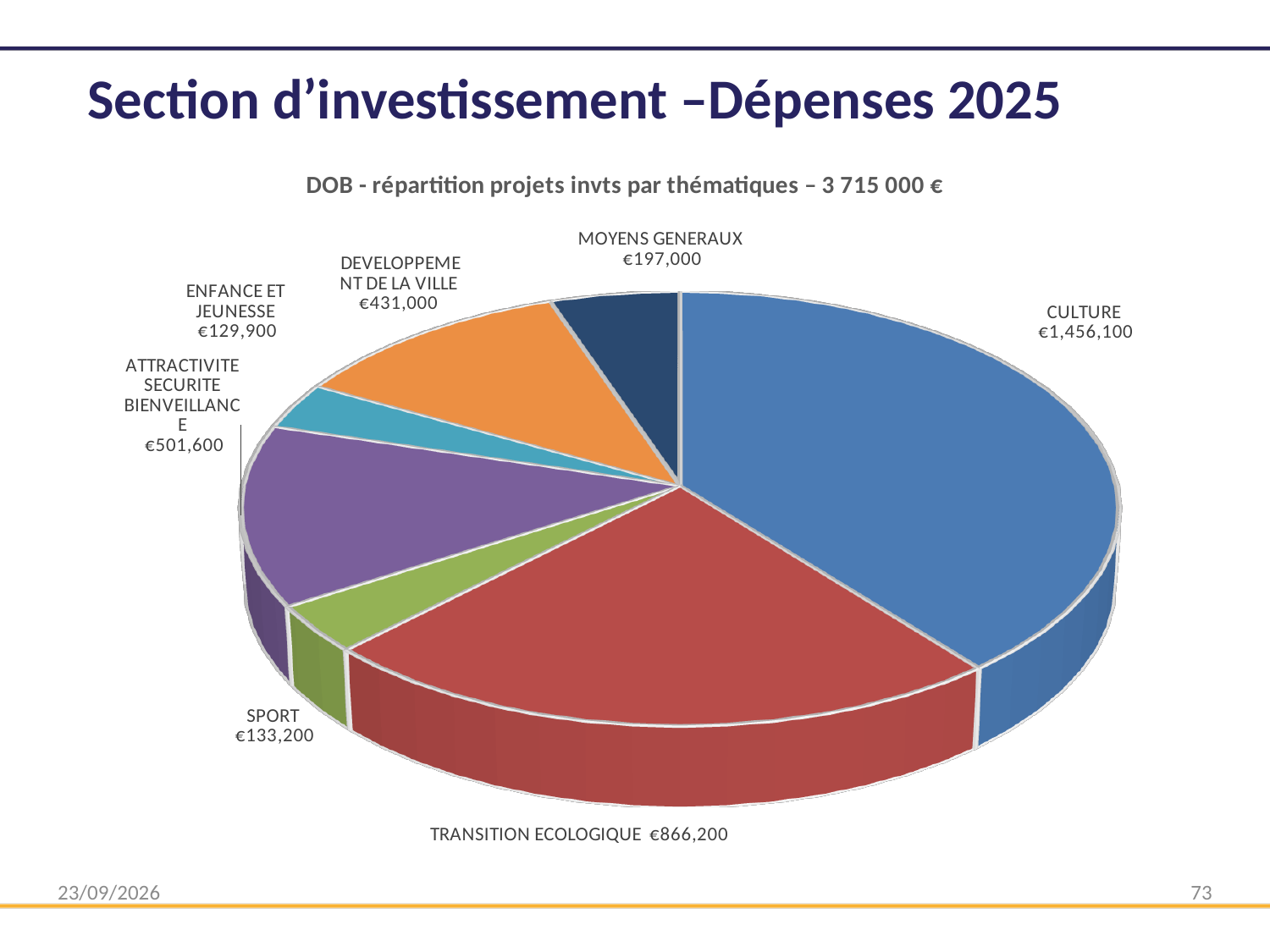
What type of chart is shown on the slide? Pie chart What is the value for TRANSITION ECOLOGIQUE? €866,200 What is the value for MOYENS GENERAUX? €197,000 Which is larger, ATTRACTIVITE SECURITE BIENVEILLANCE or DEVELOPPEMENT DE LA VILLE? ATTRACTIVITE SECURITE BIENVEILLANCE What total amount is stated in the chart title? 3 715 000 € What is the value for ATTRACTIVITE SECURITE BIENVEILLANCE? €501,600 What is the difference between DEVELOPPEMENT DE LA VILLE and MOYENS GENERAUX? €234,000 What is the value for CULTURE? €1,456,100 Which category has the smallest value? ENFANCE ET JEUNESSE Which category has the largest slice? CULTURE What is the difference between CULTURE and TRANSITION ECOLOGIQUE? €589,900 How many categories (slices) does the pie chart have? 7